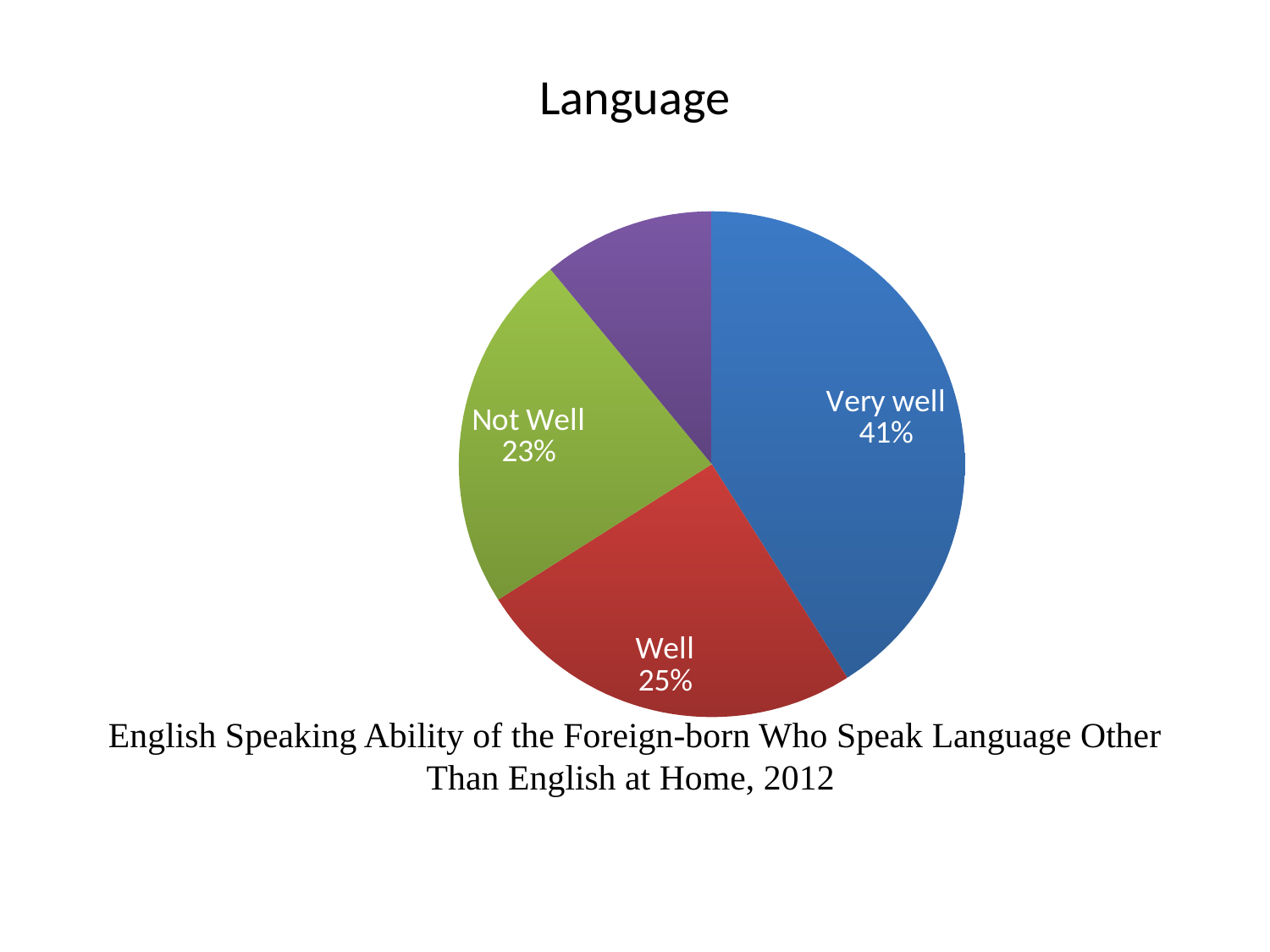
Which is larger, the "Very well" slice or the "Well" slice? Very well What percentage is shown for the "Well" slice? 25% By how many percentage points does "Well" exceed "Not Well"? 2 What percentage of the pie is the "Very well" slice? 41% How many slices does the pie chart have? 4 What colour is the "Very well" slice? blue By how many percentage points does "Very well" exceed "Well"? 16 Which labelled slice has the largest share of the pie? Very well What percentage is shown for the "Not Well" slice? 23% What kind of chart is shown on the slide? pie chart What is the title shown at the top of the slide? Language Which is larger, the "Well" slice or the "Not Well" slice? Well